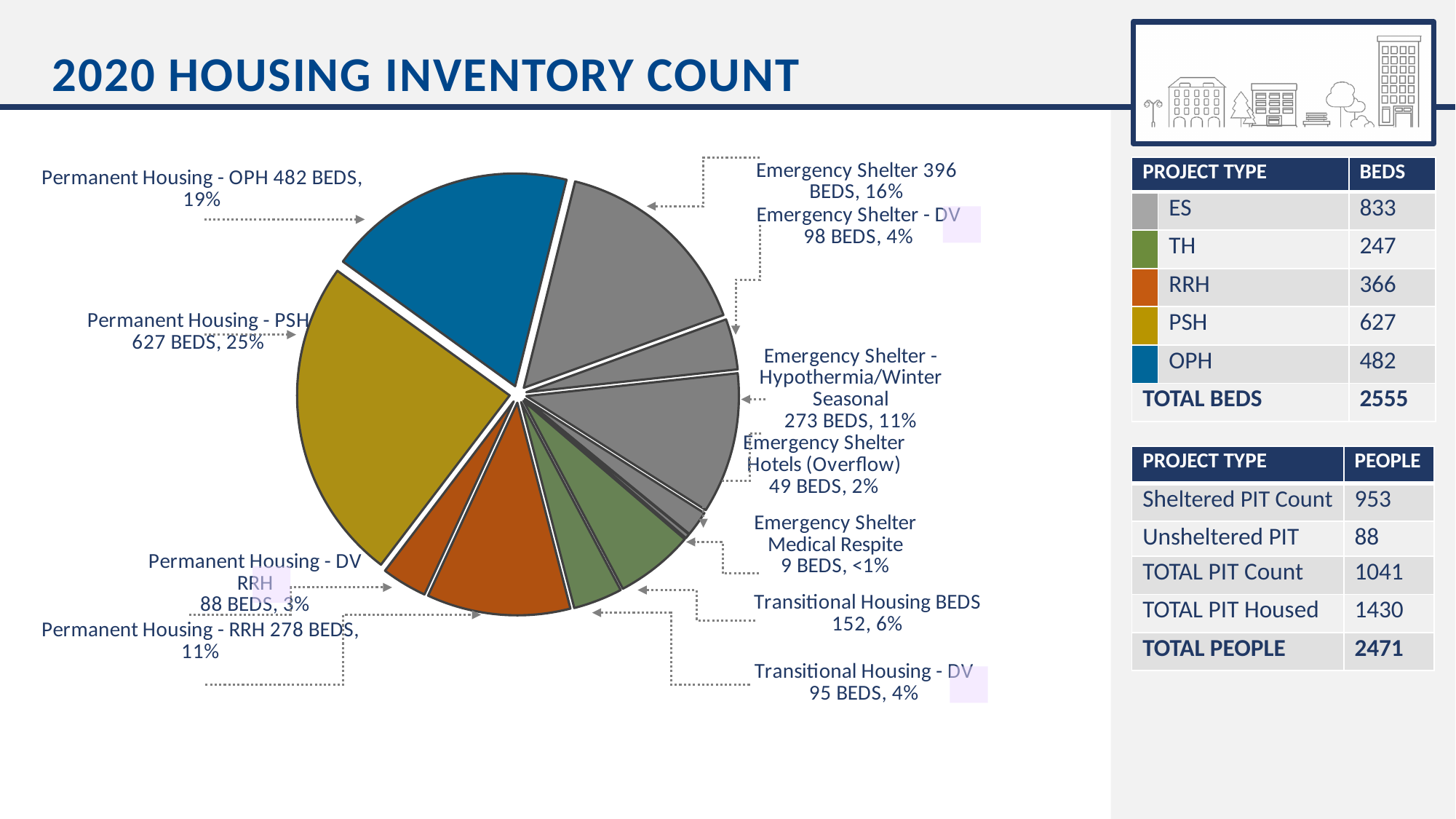
What is the difference in beds between Transitional Housing and Transitional Housing - DV? 57 What is the title of the slide containing the pie chart? 2020 HOUSING INVENTORY COUNT What is the difference in beds between Permanent Housing - PSH and Permanent Housing - OPH? 145 What share of the pie does Transitional Housing - DV account for? 4% How many slices does the pie chart have? 11 Which has more beds, Emergency Shelter (396 beds) or Permanent Housing - RRH? Emergency Shelter How many beds does the Emergency Shelter - Hypothermia/Winter Seasonal slice represent? 273 BEDS Which slice of the pie chart has the fewest beds? Emergency Shelter Medical Respite Which slice of the pie chart has the most beds? Permanent Housing - PSH What share of the pie does Permanent Housing - OPH account for? 19% What kind of chart is shown on the slide? pie chart How many beds does the Permanent Housing - PSH slice represent? 627 BEDS